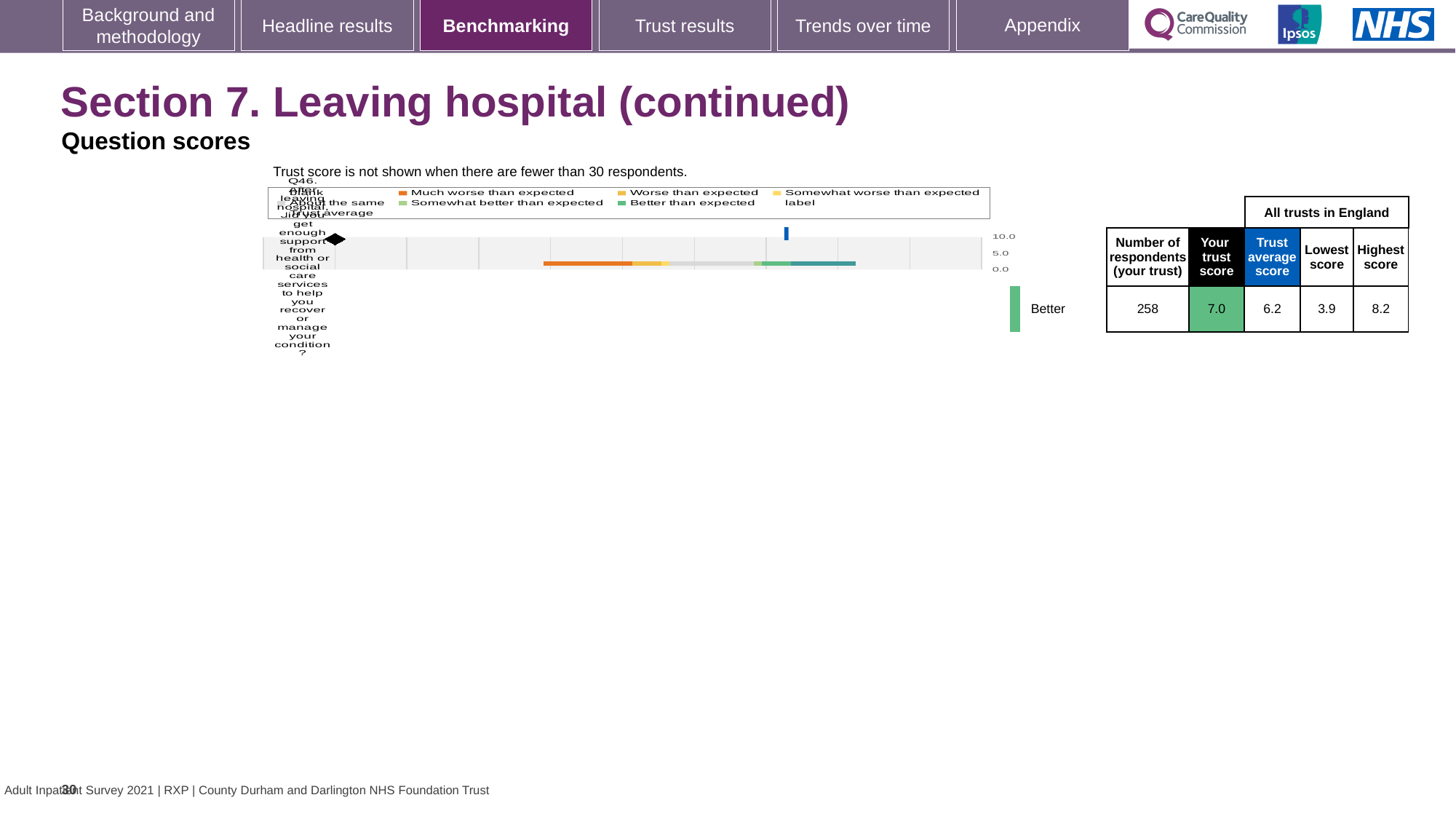
What benchmark category label is shown next to the green bar to the right of the chart? Better What kind of chart is used to show the Q46 benchmarking result? Bar chart Which is larger for Q46: the trust score or the trust average score? Trust score What is the difference between the highest and lowest scores for Q46 across all trusts in England? 4.3 What is the trust score for Q46 shown in the table? 7.0 By how much does the trust score for Q46 exceed the trust average score? 0.8 How many questions are plotted on the benchmarking chart on this slide? 1 What is the highest score among all trusts in England for Q46? 8.2 What is the lowest score among all trusts in England for Q46? 3.9 How many respondents from the trust answered Q46? 258 Is the trust score for Q46 greater or less than 5.0 on the chart's scale? greater What is the trust average score for Q46 across all trusts in England? 6.2